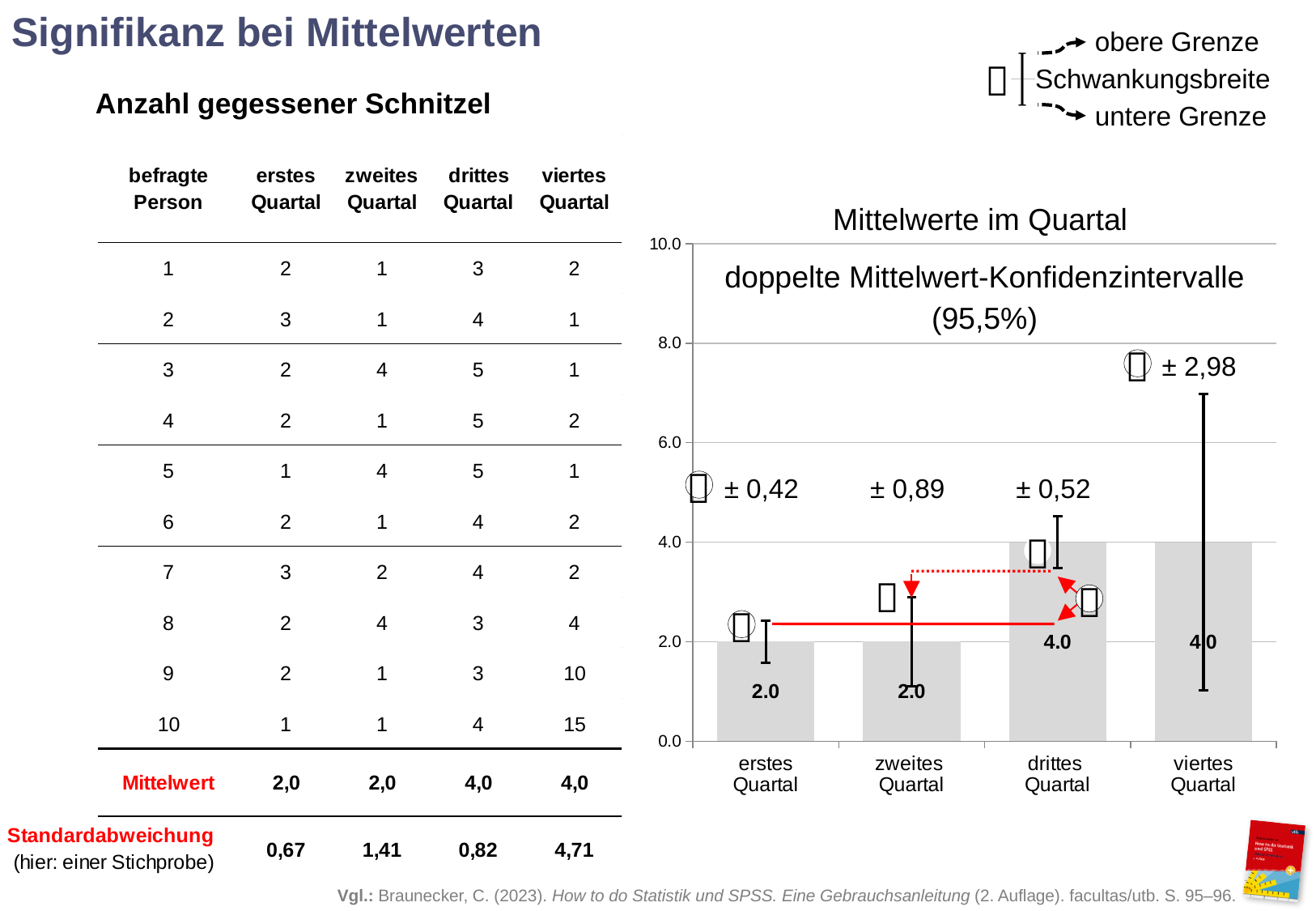
What kind of chart is "Mittelwerte im Quartal"? bar chart In the chart "Mittelwerte im Quartal", is the value for viertes Quartal greater or less than 6.0? less In the chart "Mittelwerte im Quartal", what confidence interval (±) is printed for erstes Quartal? ± 0,42 In the chart "Mittelwerte im Quartal", what is the value for viertes Quartal? 4.0 In the chart "Mittelwerte im Quartal", what is the difference between the values for drittes Quartal and zweites Quartal? 2.0 In the chart "Mittelwerte im Quartal", which is larger, the value for erstes Quartal or the value for drittes Quartal? drittes Quartal What is the title of the chart on the right of the slide? Mittelwerte im Quartal How many categories are shown on the x axis of the chart "Mittelwerte im Quartal"? 4 In the chart "Mittelwerte im Quartal", which category has the widest confidence interval (±)? viertes Quartal In the chart "Mittelwerte im Quartal", what is the value for erstes Quartal? 2.0 In the chart "Mittelwerte im Quartal", what confidence interval (±) is printed for viertes Quartal? ± 2,98 In the chart "Mittelwerte im Quartal", what is the value for drittes Quartal? 4.0